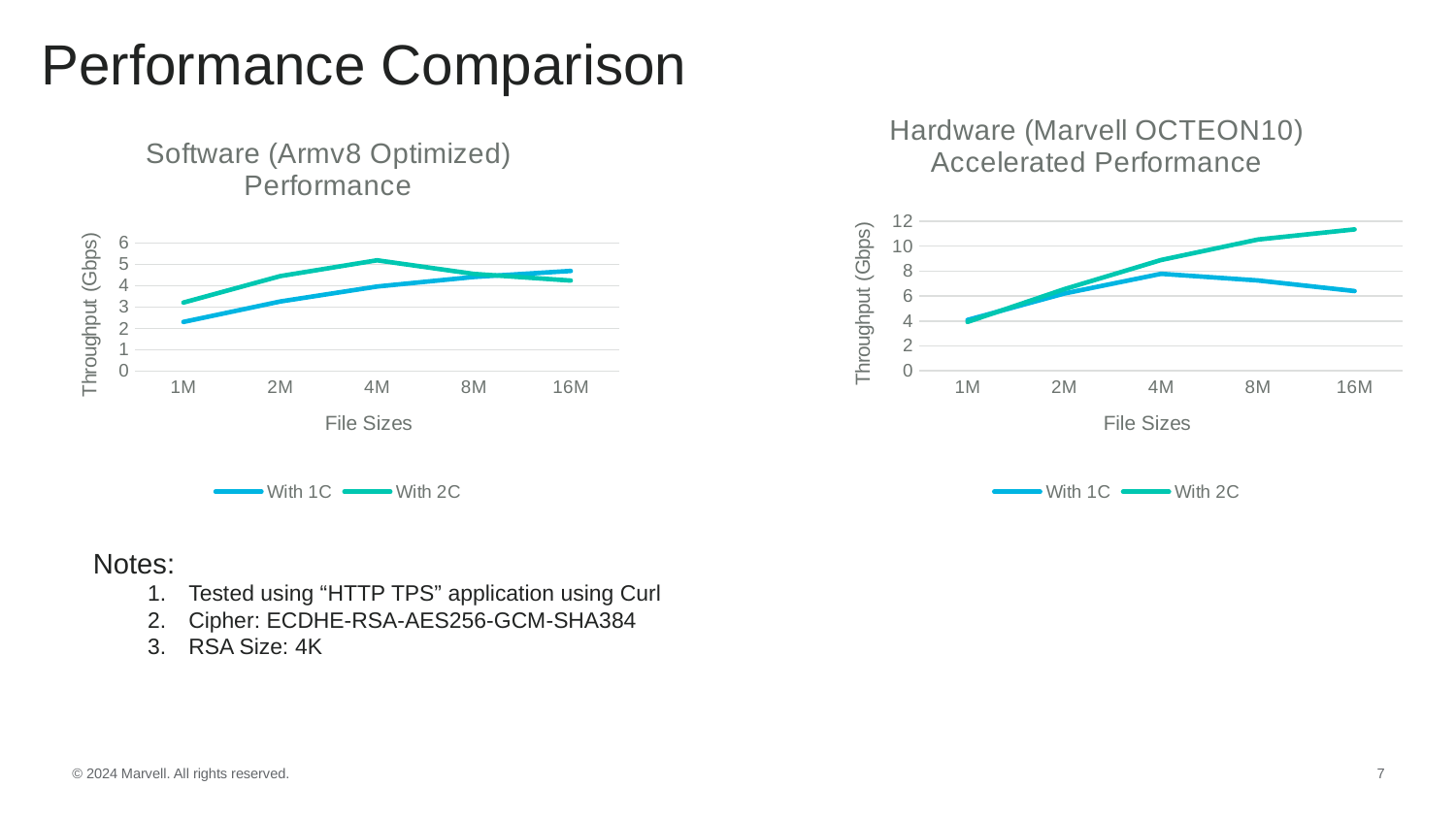
How many series does the legend of the Hardware (Marvell OCTEON10) Accelerated Performance chart list? 2 In the Hardware (Marvell OCTEON10) Accelerated Performance chart, which series has the higher throughput at 16M, With 1C or With 2C? With 2C How many file sizes are shown on the x axis of the Software (Armv8 Optimized) Performance chart? 5 In the Software (Armv8 Optimized) Performance chart, at which file size is the With 1C series lowest? 1M In the Hardware (Marvell OCTEON10) Accelerated Performance chart, at which file size does the With 2C series reach its highest throughput? 16M In the Hardware (Marvell OCTEON10) Accelerated Performance chart, is the With 2C value at 16M greater or less than 10? greater In the Software (Armv8 Optimized) Performance chart, is the With 1C value at 1M greater or less than 3? less What kind of chart is the Software (Armv8 Optimized) Performance chart? Line chart In the Software (Armv8 Optimized) Performance chart, at which file size does the With 2C series reach its highest throughput? 4M In the Software (Armv8 Optimized) Performance chart, is the With 2C value at 4M greater or less than 5? greater In the Hardware (Marvell OCTEON10) Accelerated Performance chart, does the With 2C series rise or fall as file size increases from 1M to 16M? Rise What is the y-axis label on the Hardware (Marvell OCTEON10) Accelerated Performance chart? Throughput (Gbps)